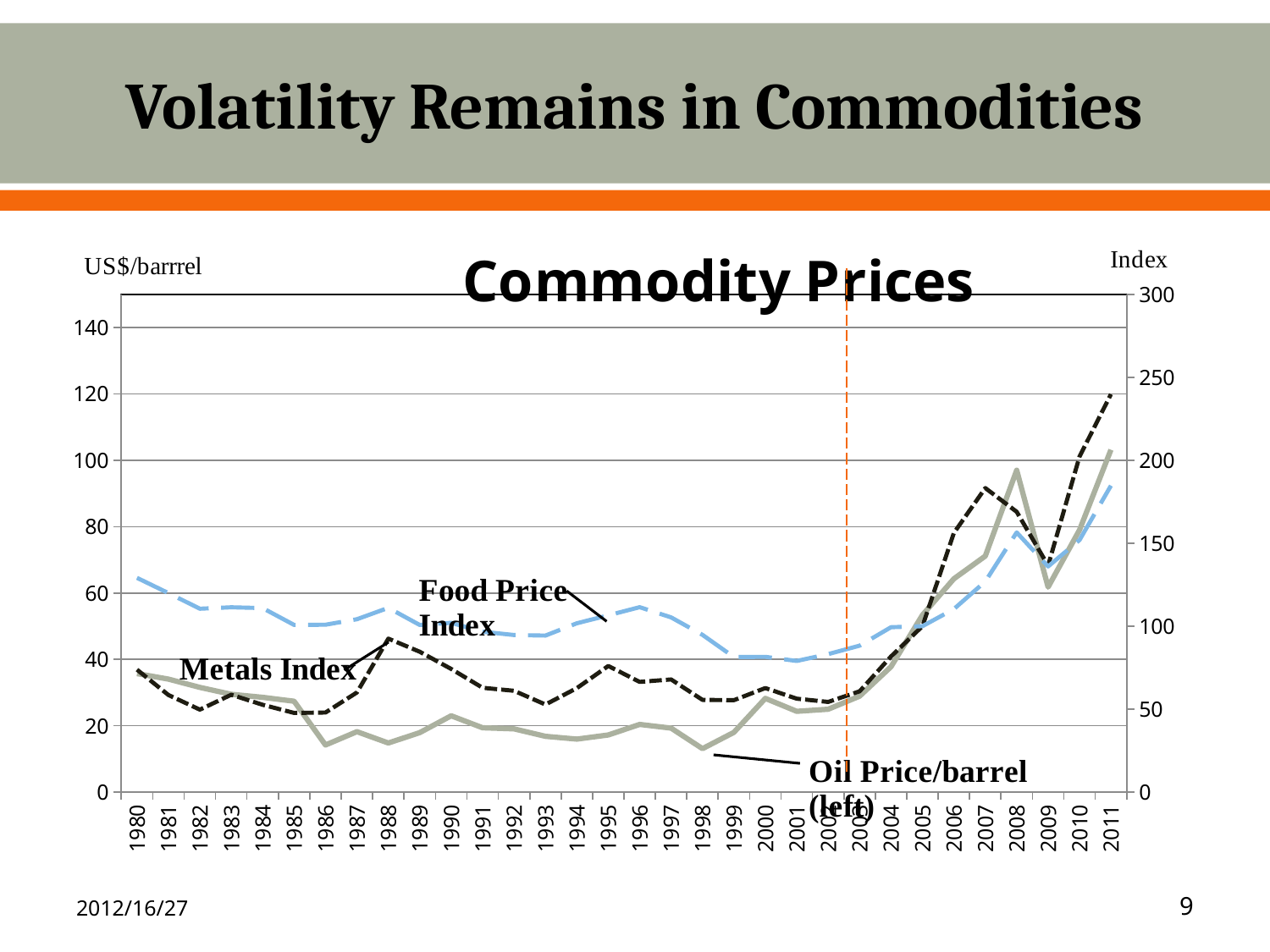
How many years are plotted along the x axis of the chart? 32 What is the label on the left vertical axis of the chart? US$/barrrel Is the Food Price Index value for 1980 greater or less than 100 on the right axis? greater Is the Oil Price/barrel value for 2008 greater or less than 80 on the left axis? greater What kind of chart is shown on the slide? line chart In 2011, which is higher, the Metals Index or the Food Price Index? Metals Index Is the Food Price Index value for 2001 greater or less than 100 on the right axis? less Does the Oil Price/barrel rise or fall from 2009 to 2011? rise What is the title of the chart? Commodity Prices In which year does the Metals Index reach its highest value? 2011